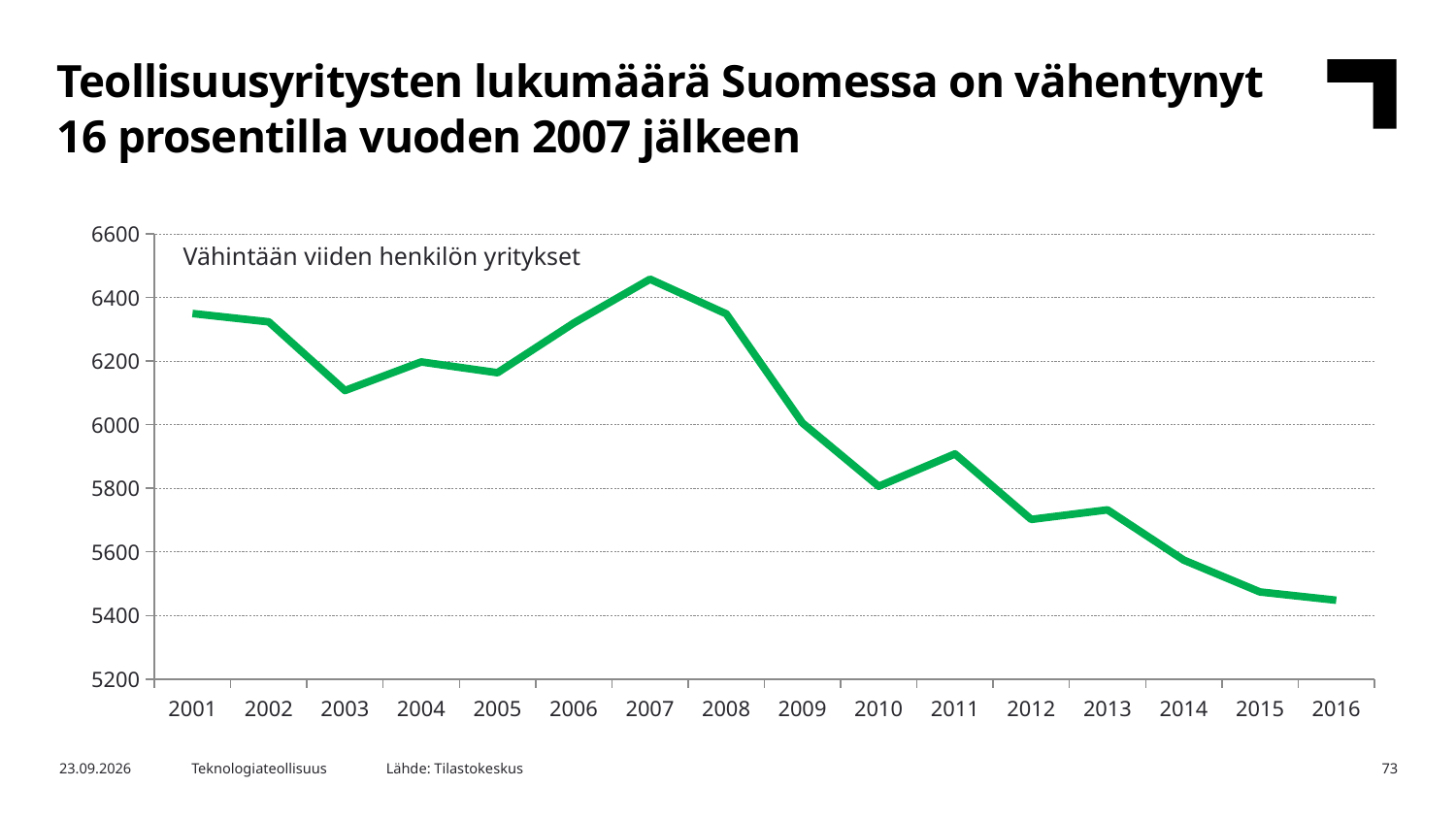
Which year has the larger value, 2011 or 2012? 2011 What text label is shown inside the plot area of the chart? Vähintään viiden henkilön yritykset Does the line generally rise or fall from 2007 to 2016? Fall Which year has the highest value on the chart? 2007 Is the value for 2007 greater or less than 6400? greater Is the value for 2016 greater or less than 5600? less Which year has the larger value, 2003 or 2007? 2007 Is the value for 2011 greater or less than 5800? greater What kind of chart is shown on the slide? Line chart How many years are plotted on the x axis? 16